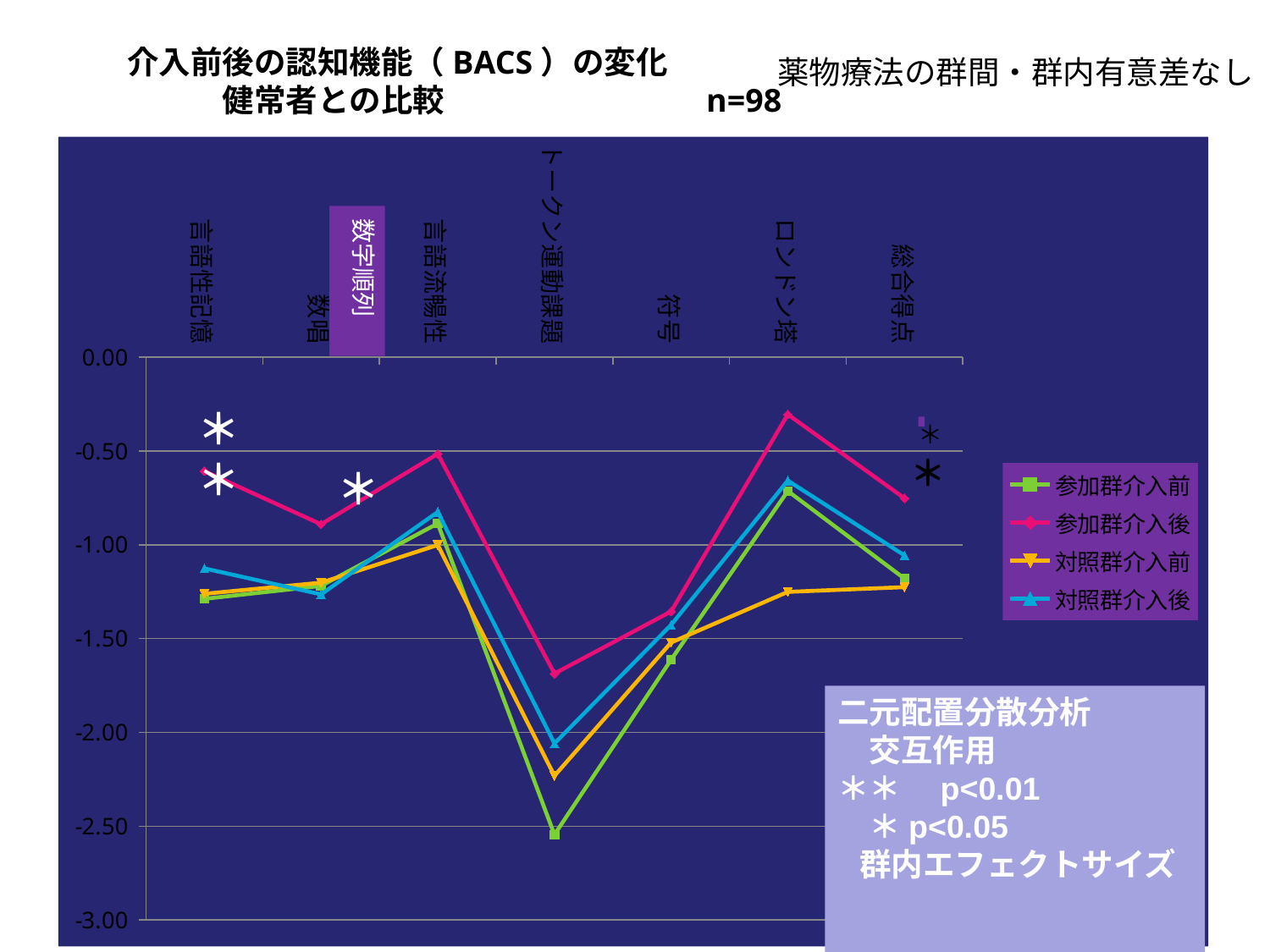
Is the value of 参加群介入後 at ロンドン塔 greater or less than -0.50? greater At ロンドン塔, which is larger: the value for 参加群介入後 or 対照群介入前? 参加群介入後 How many series does the legend list? 4 Which series is drawn in pink? 参加群介入後 Is the value of 対照群介入後 at 言語性記憶 greater or less than -1.50? greater Is the value of 対照群介入前 at トークン運動課題 greater or less than -2.00? less What sample size (n) is stated on the slide? n=98 For the 参加群介入前 series, which category has the lowest value? トークン運動課題 At トークン運動課題, which is larger: the value for 参加群介入前 or 参加群介入後? 参加群介入後 What kind of chart is shown on the slide? line chart For the 参加群介入後 series, which category has the highest value? ロンドン塔